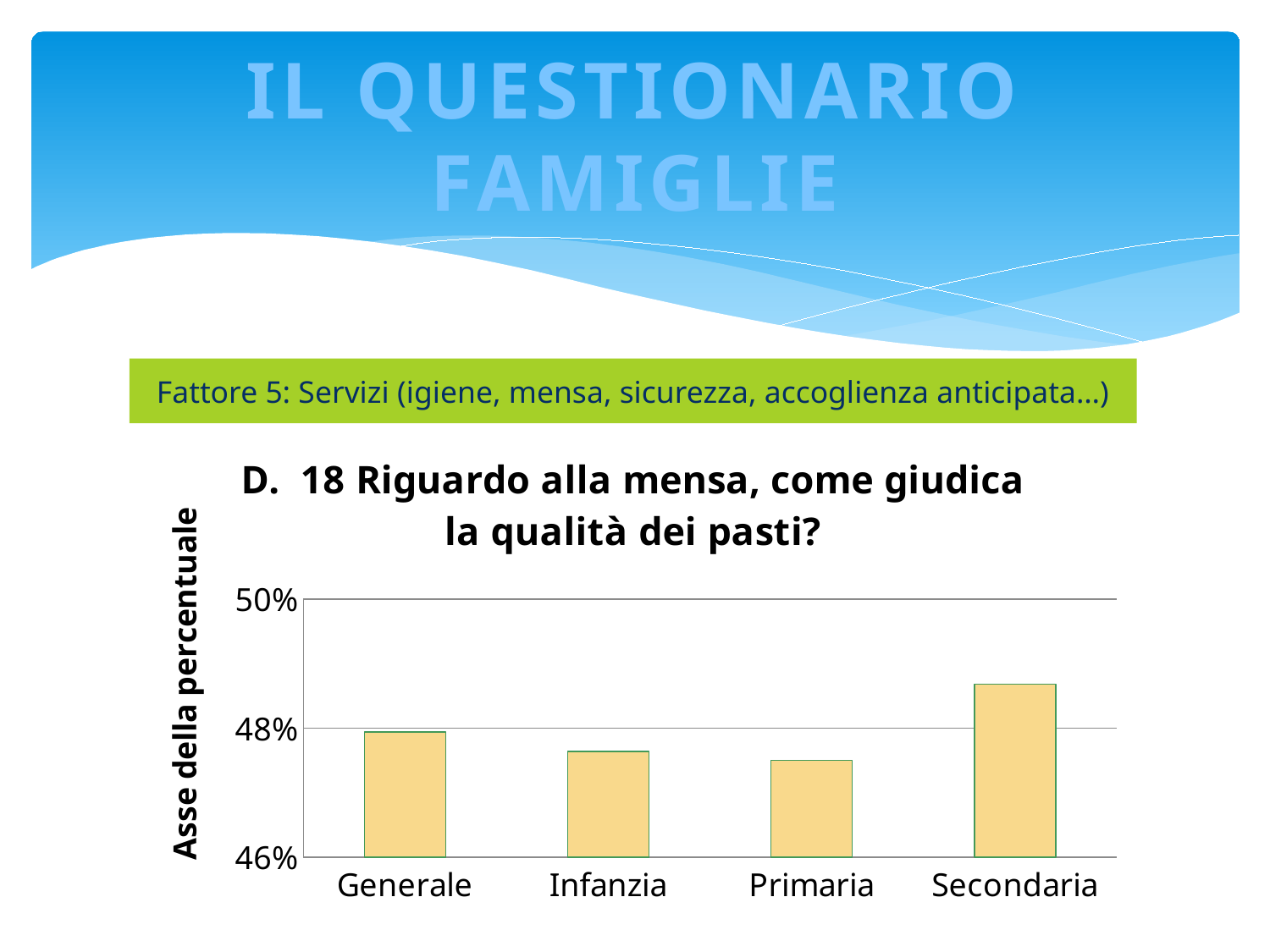
Is the value for Infanzia greater or less than 48%? less What is the label of the vertical axis of the chart? Asse della percentuale Is the value for Secondaria greater or less than 48%? greater How many categories are shown on the x axis of the chart? 4 Which category has the highest value in the chart? Secondaria What is the title of the chart? D. 18 Riguardo alla mensa, come giudica la qualità dei pasti? Is the value for Primaria greater or less than 48%? less Which is larger, the value for Generale or the value for Primaria? Generale Which is larger, the value for Secondaria or the value for Generale? Secondaria What kind of chart is shown on the slide? bar chart